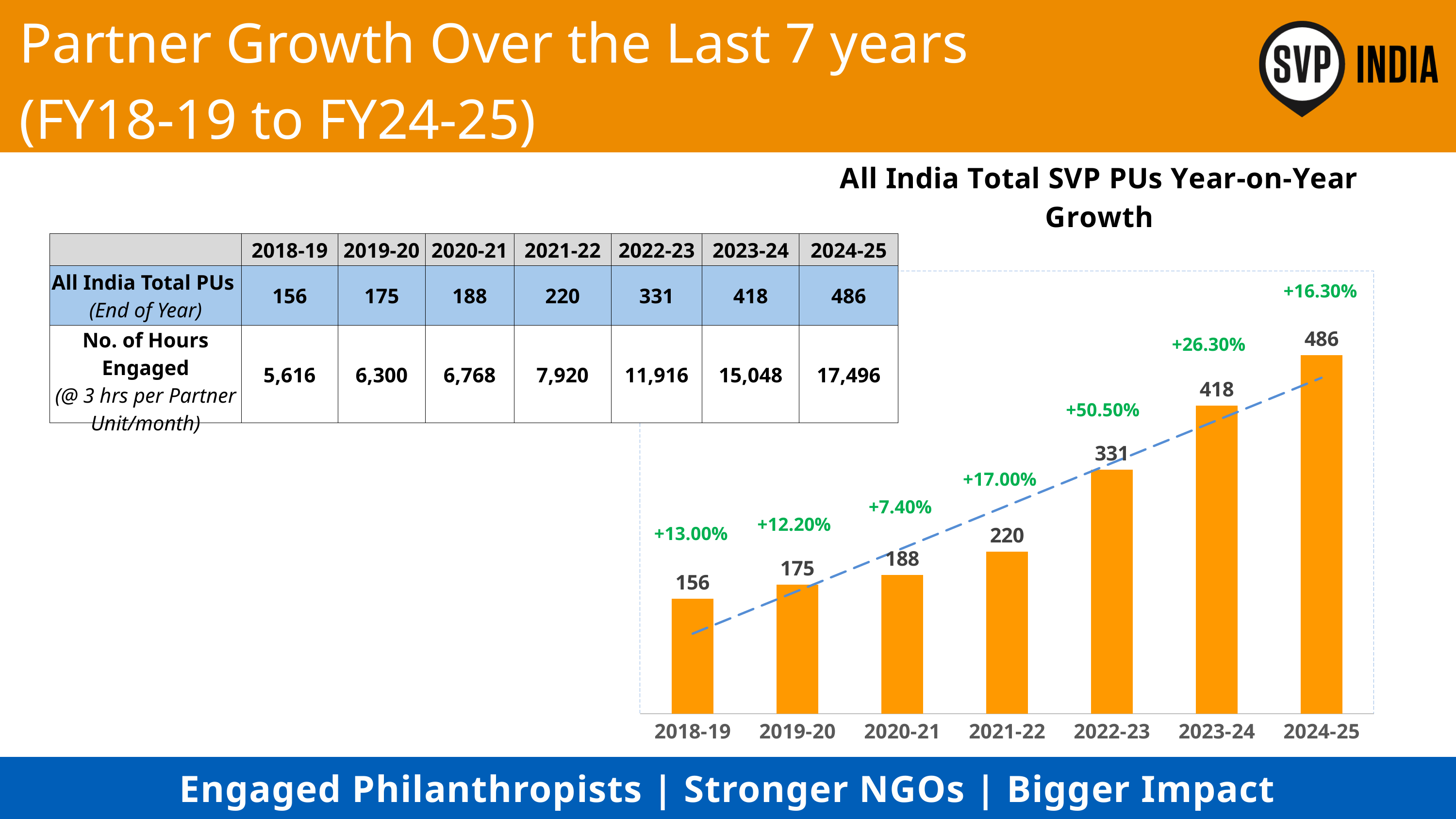
How many years (bars) are shown in the All India Total SVP PUs chart? 7 What kind of chart is used to show All India Total SVP PUs Year-on-Year Growth? Bar chart Which is larger in the chart, the value for 2020-21 or the value for 2021-22? 2021-22 What is the value for 2022-23 in the All India Total SVP PUs Year-on-Year Growth chart? 331 What year-on-year growth percentage is shown above the 2024-25 bar? +16.30% What year-on-year growth percentage is shown above the 2022-23 bar? +50.50% What is the difference between the 2024-25 and 2023-24 values in the chart? 68 Which year has the highest value in the All India Total SVP PUs chart? 2024-25 What is the value for 2018-19 in the All India Total SVP PUs Year-on-Year Growth chart? 156 What is the difference between the 2022-23 and 2021-22 values in the chart? 111 Do the values in the All India Total SVP PUs chart rise or fall from 2018-19 to 2024-25? Rise Which year has the lowest value in the All India Total SVP PUs chart? 2018-19